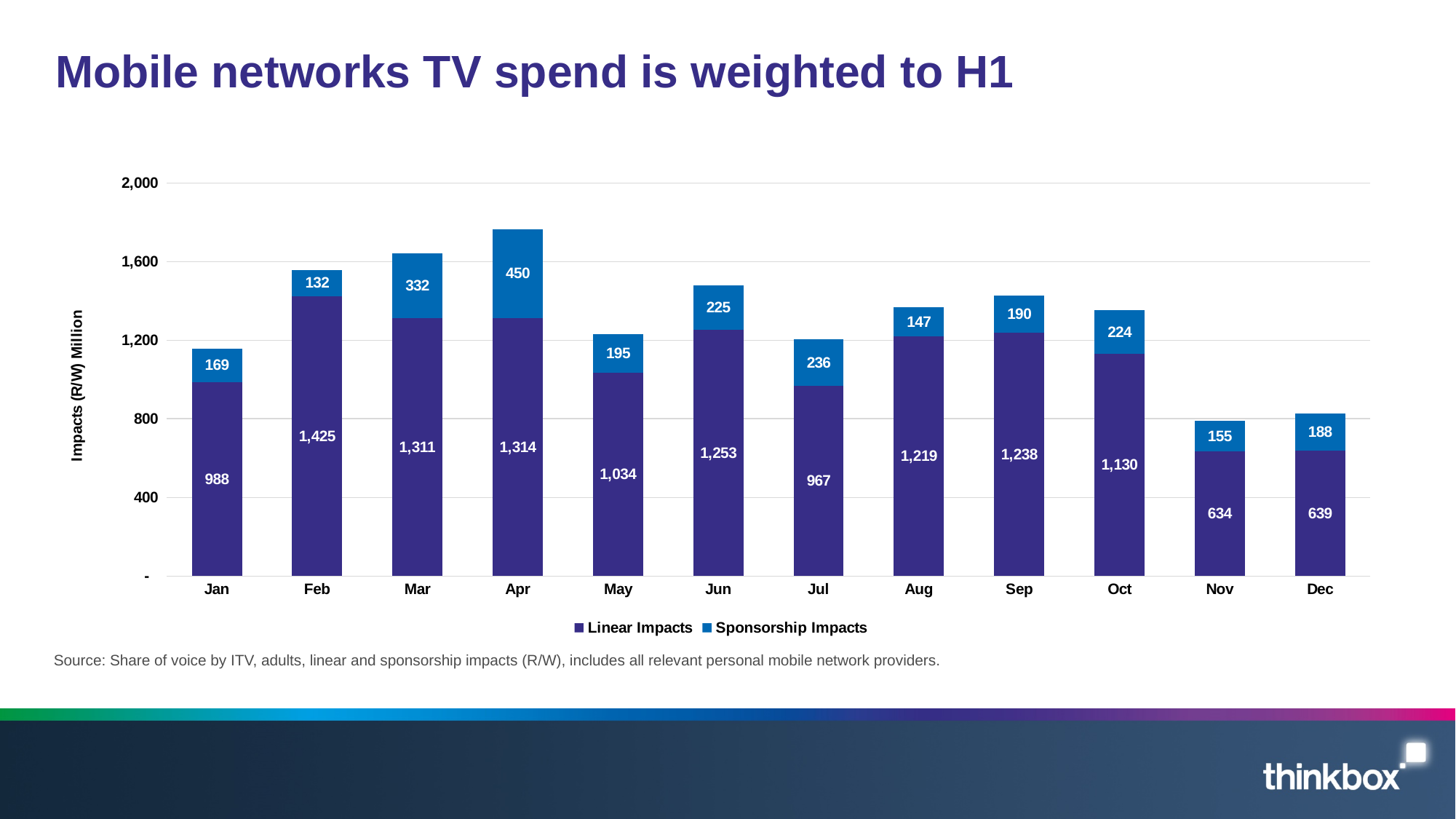
What is the Sponsorship Impacts value for Apr? 450 What kind of chart is shown on the slide? Stacked bar chart Which month has the lowest Sponsorship Impacts value? Feb How many series does the legend list? 2 What is the label on the y axis? Impacts (R/W) Million Which month has the highest Linear Impacts value? Feb Is the total height of the Apr bar greater or less than 1,600? greater What is the difference between the Linear Impacts values for Feb and Jan? 437 What is the total of the stacked bar for Mar? 1,643 Which is larger, the Sponsorship Impacts value for Jul or for Oct? Jul How many months are shown on the x axis? 12 What is the Linear Impacts value for Feb? 1,425